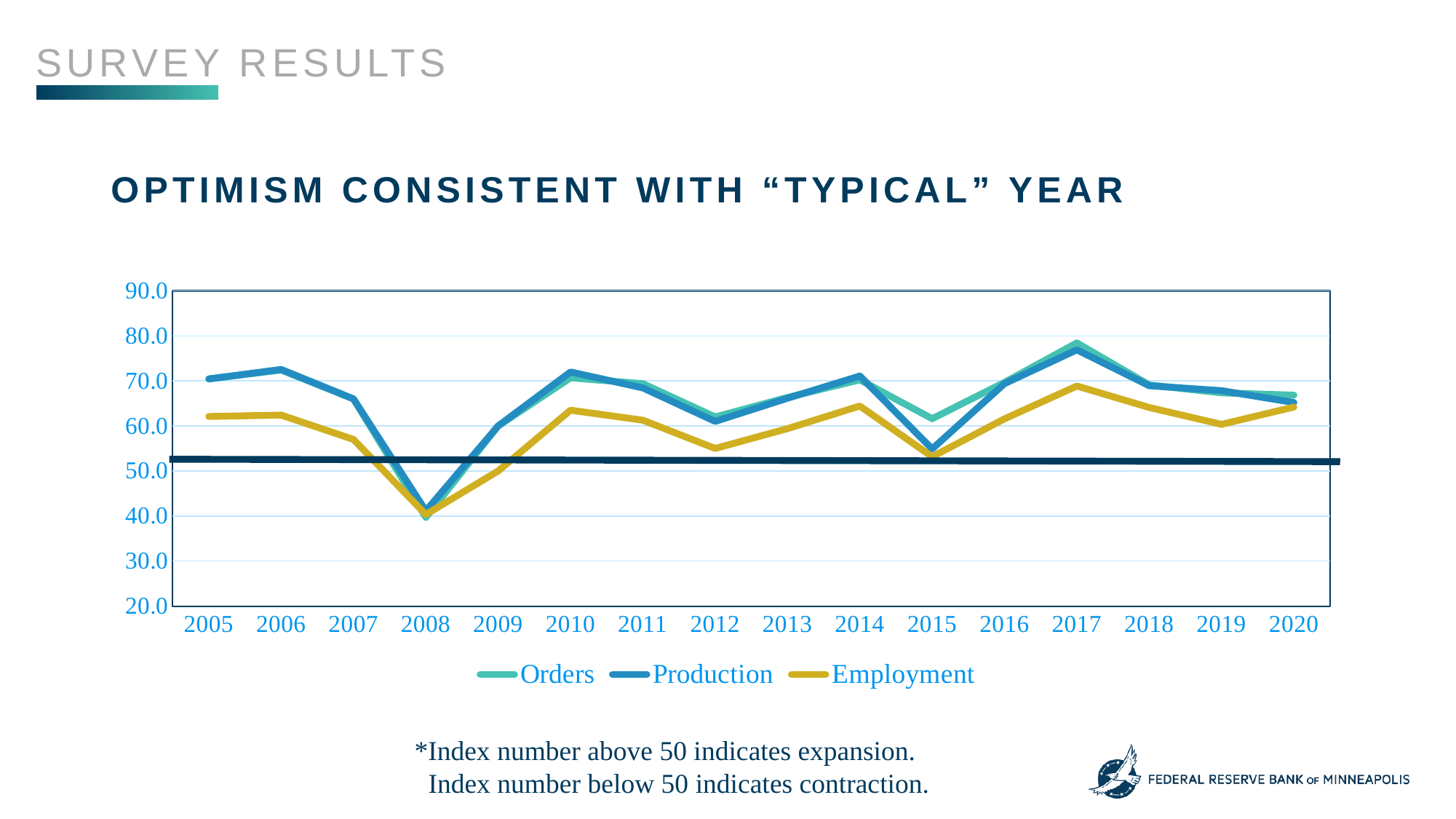
What is the title of the chart? Optimism Consistent with "Typical" Year Is the value for Production in 2008 greater or less than 50? less In 2010, which is larger: Production or Employment? Production In which year is the Orders series at its highest? 2017 What kind of chart is shown on the slide? Line chart Is the value for Orders in 2017 greater or less than 70? greater In which year is the Employment series at its lowest? 2008 How many series does the legend list? 3 Which series are listed in the legend? Orders, Production, Employment How many years are plotted along the x axis? 16 Is the value for Employment in 2012 greater or less than 50? greater Does the Production series rise or fall from 2017 to 2019? Fall